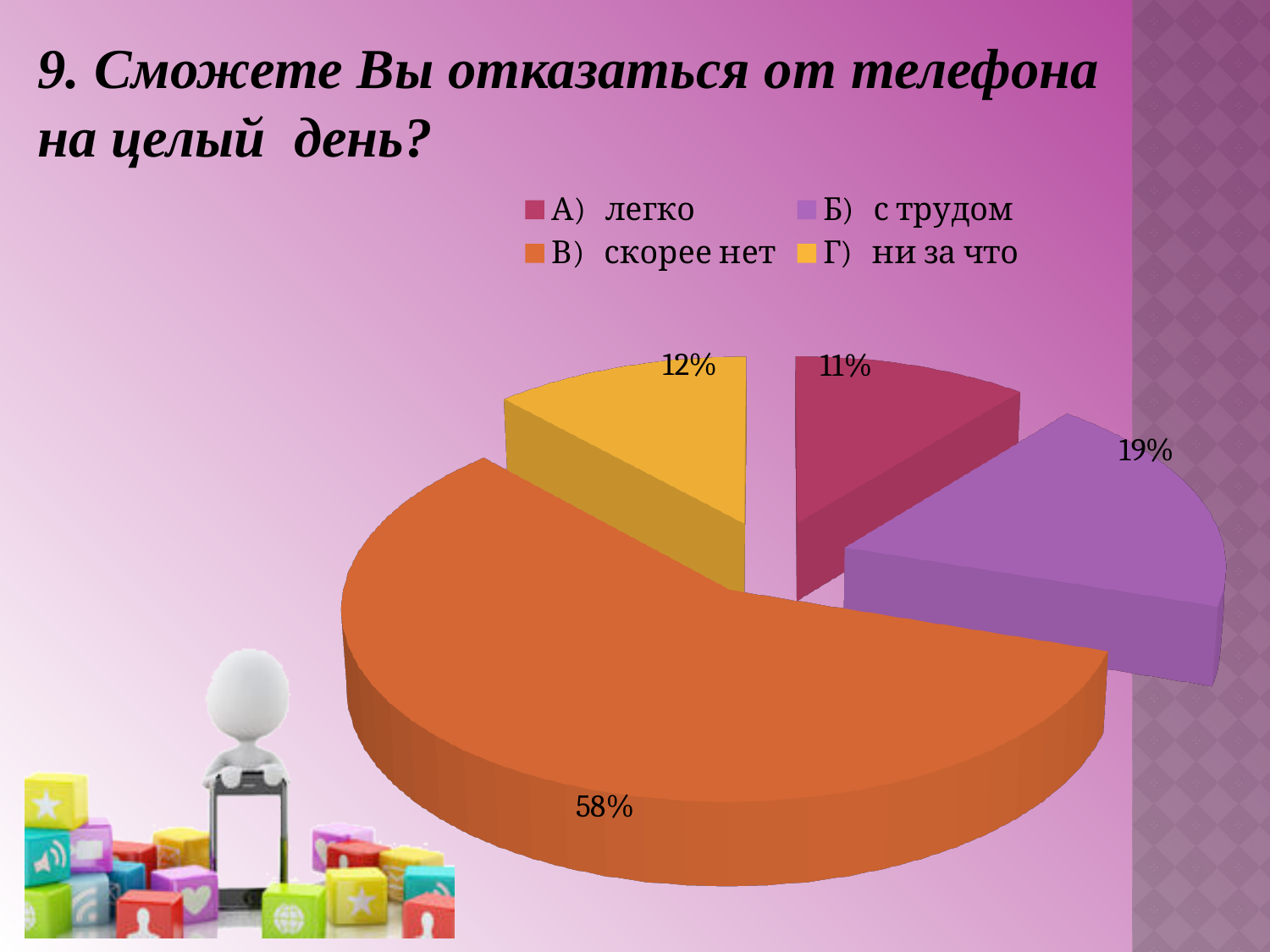
How many slices does the pie chart have? 4 What percentage of respondents answered "Г) ни за что"? 12% What is the difference in percentage points between "В) скорее нет" and "Б) с трудом"? 39 Which is larger: the share for "Б) с трудом" or the share for "Г) ни за что"? Б) с трудом What kind of chart is shown on the slide? pie chart What percentage of respondents answered "В) скорее нет"? 58% What percentage of respondents answered "Б) с трудом"? 19% What colour is the slice for "Г) ни за что"? yellow What percentage of respondents answered "А) легко"? 11% Which answer option has the largest share of the pie? В) скорее нет Which answer option has the smallest share of the pie? А) легко How many entries does the legend list? 4